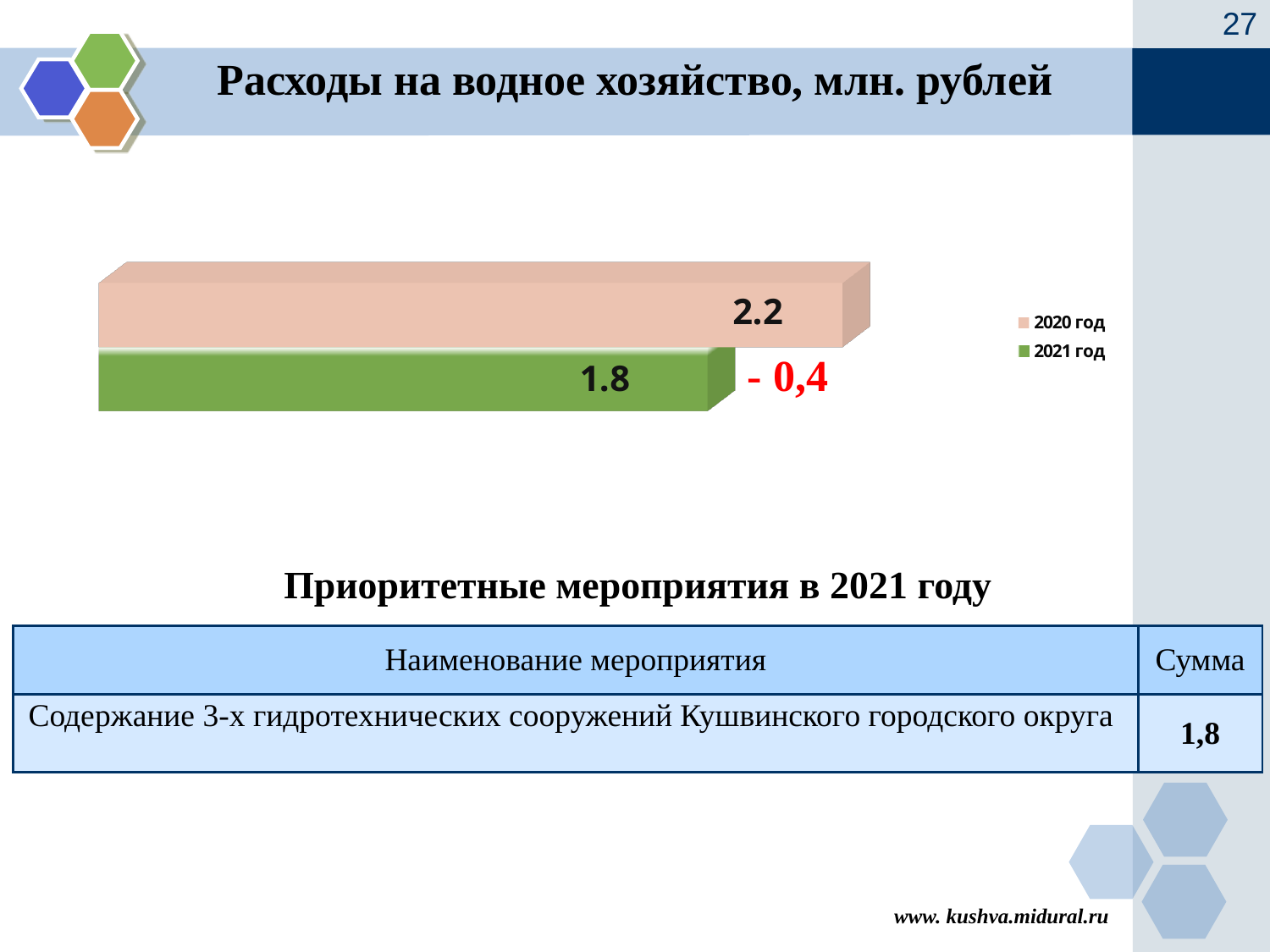
Which series has the lowest value in the chart? 2021 год What is the title of the chart on the slide? Расходы на водное хозяйство, млн. рублей Which series has the highest value in the chart? 2020 год What is the value for 2021 год in the chart? 1.8 What change is annotated in red next to the 2021 год bar? - 0,4 What colour is the bar for 2021 год in the chart? green What is the difference between the 2020 год value and the 2021 год value in the chart? 0.4 What is the value for 2020 год in the chart? 2.2 Which year has the higher value in the chart, 2020 год or 2021 год? 2020 год What kind of chart is shown on the slide? bar chart How many series does the chart legend list? 2 How many bars are plotted in the chart? 2